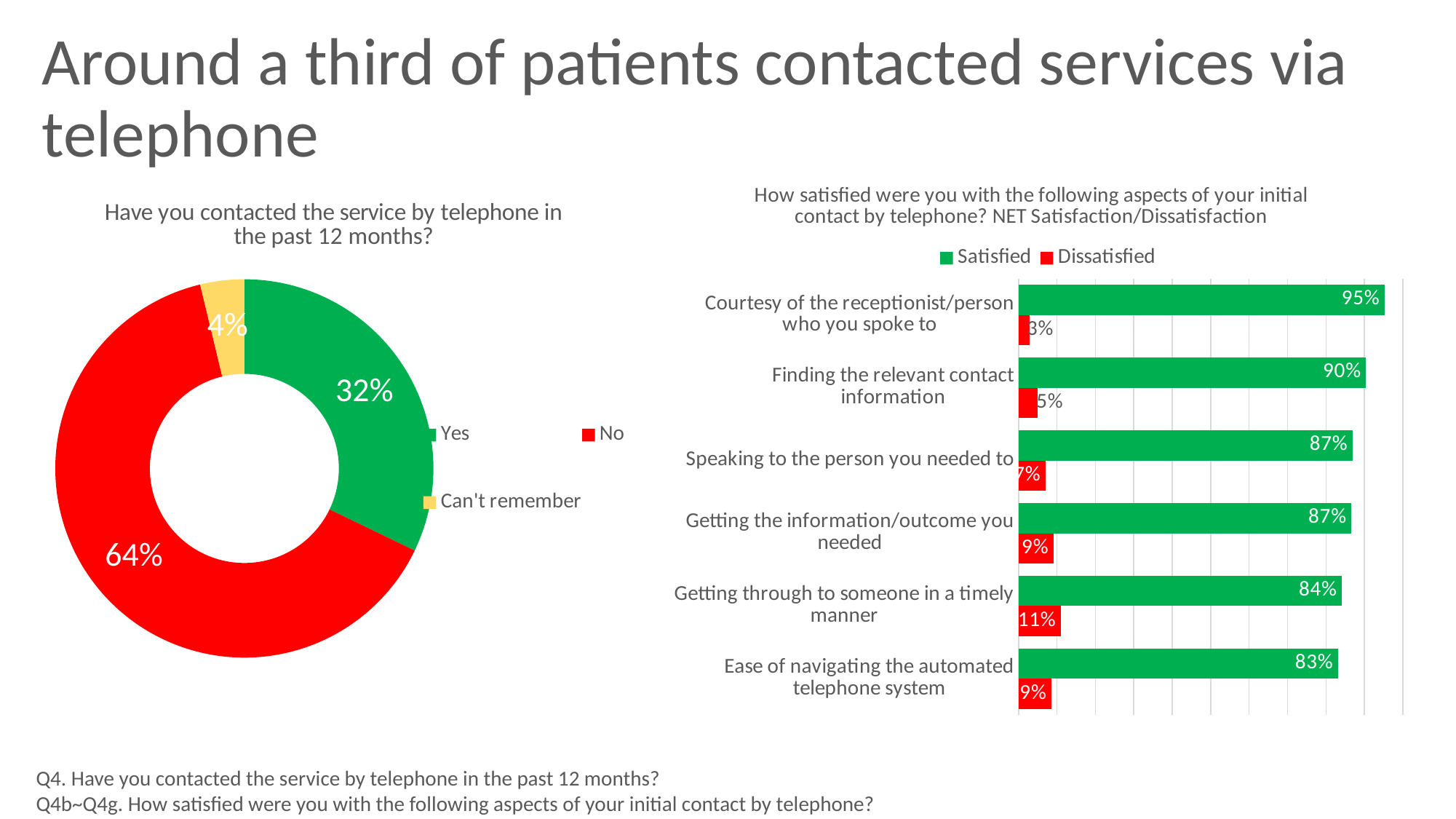
In the satisfaction chart on the right, which aspect has the lowest Satisfied value? Ease of navigating the automated telephone system In the satisfaction chart on the right, what kind of chart is used? Bar chart In the chart 'Have you contacted the service by telephone in the past 12 months?', what percentage answered Yes? 32% In the chart 'Have you contacted the service by telephone in the past 12 months?', which response has the smallest share? Can't remember In the chart 'Have you contacted the service by telephone in the past 12 months?', what percentage answered No? 64% In the satisfaction chart on the right, which aspect has the highest Dissatisfied value? Getting through to someone in a timely manner What kind of chart is 'Have you contacted the service by telephone in the past 12 months?'? Doughnut (pie) chart In the chart 'Have you contacted the service by telephone in the past 12 months?', how many categories does the legend list? 3 In the satisfaction chart on the right, how many series does the legend list? 2 In the satisfaction chart on the right, what is the Satisfied value for 'Courtesy of the receptionist/person who you spoke to'? 95% In the satisfaction chart on the right, what is the difference between the Satisfied values for 'Courtesy of the receptionist/person who you spoke to' and 'Finding the relevant contact information'? 5% In the satisfaction chart on the right, what is the Dissatisfied value for 'Getting through to someone in a timely manner'? 11%